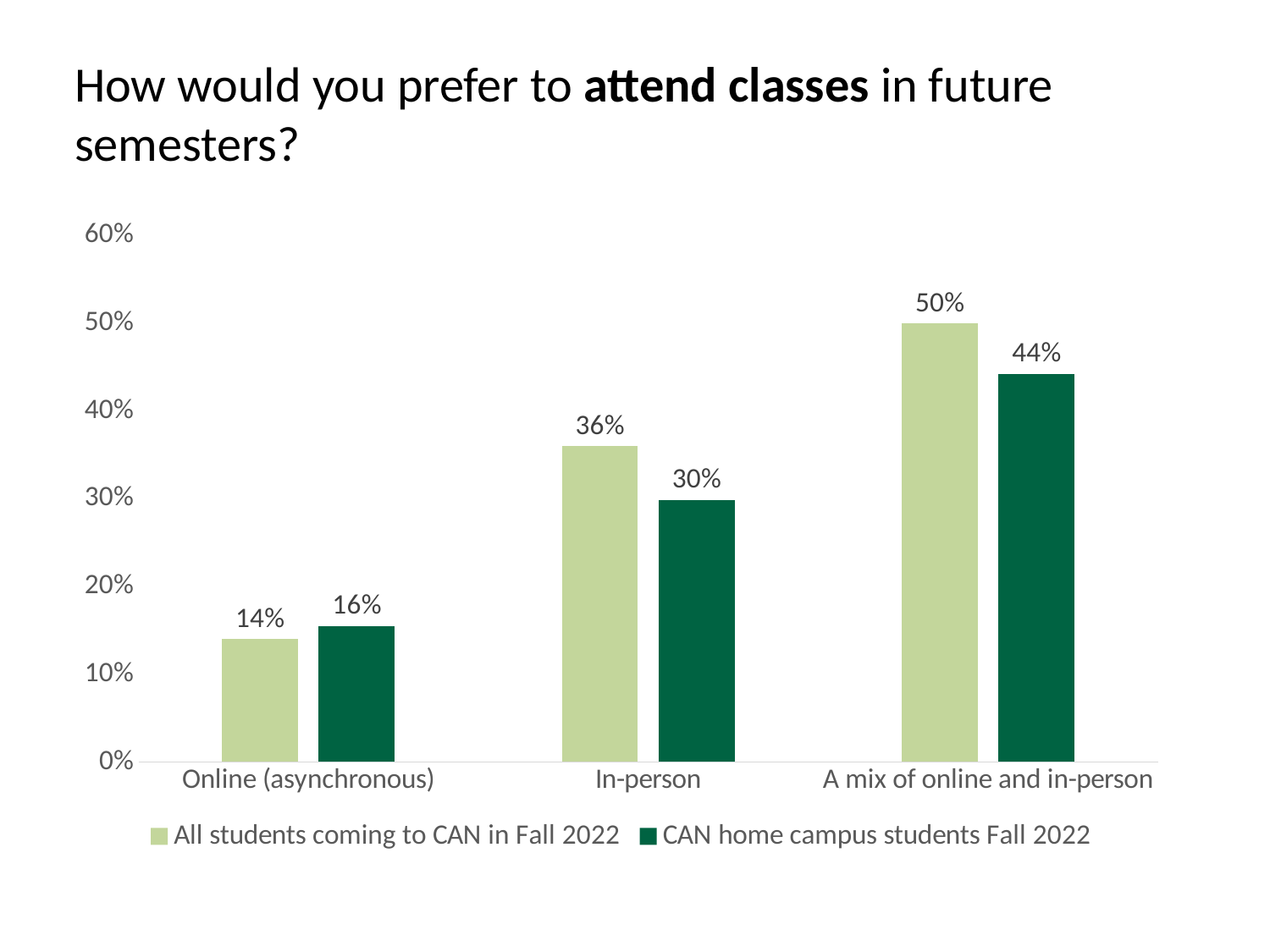
For Online (asynchronous), which series has the larger value? CAN home campus students Fall 2022 What percentage of all students coming to CAN in Fall 2022 prefer in-person classes? 36% How many series does the legend list? 2 How many attendance options are shown on the x axis? 3 What is the value for Online (asynchronous) among CAN home campus students Fall 2022? 16% Which attendance option has the lowest value for CAN home campus students Fall 2022? Online (asynchronous) Which attendance option has the highest value for all students coming to CAN in Fall 2022? A mix of online and in-person What kind of chart is shown on the slide? Bar chart Is the value for all students coming to CAN in Fall 2022 for A mix of online and in-person greater or less than 40%? greater What percentage of CAN home campus students Fall 2022 prefer a mix of online and in-person classes? 44% What is the difference between the two series for In-person? 6% Do the values for CAN home campus students Fall 2022 rise or fall from left to right across the categories? Rise